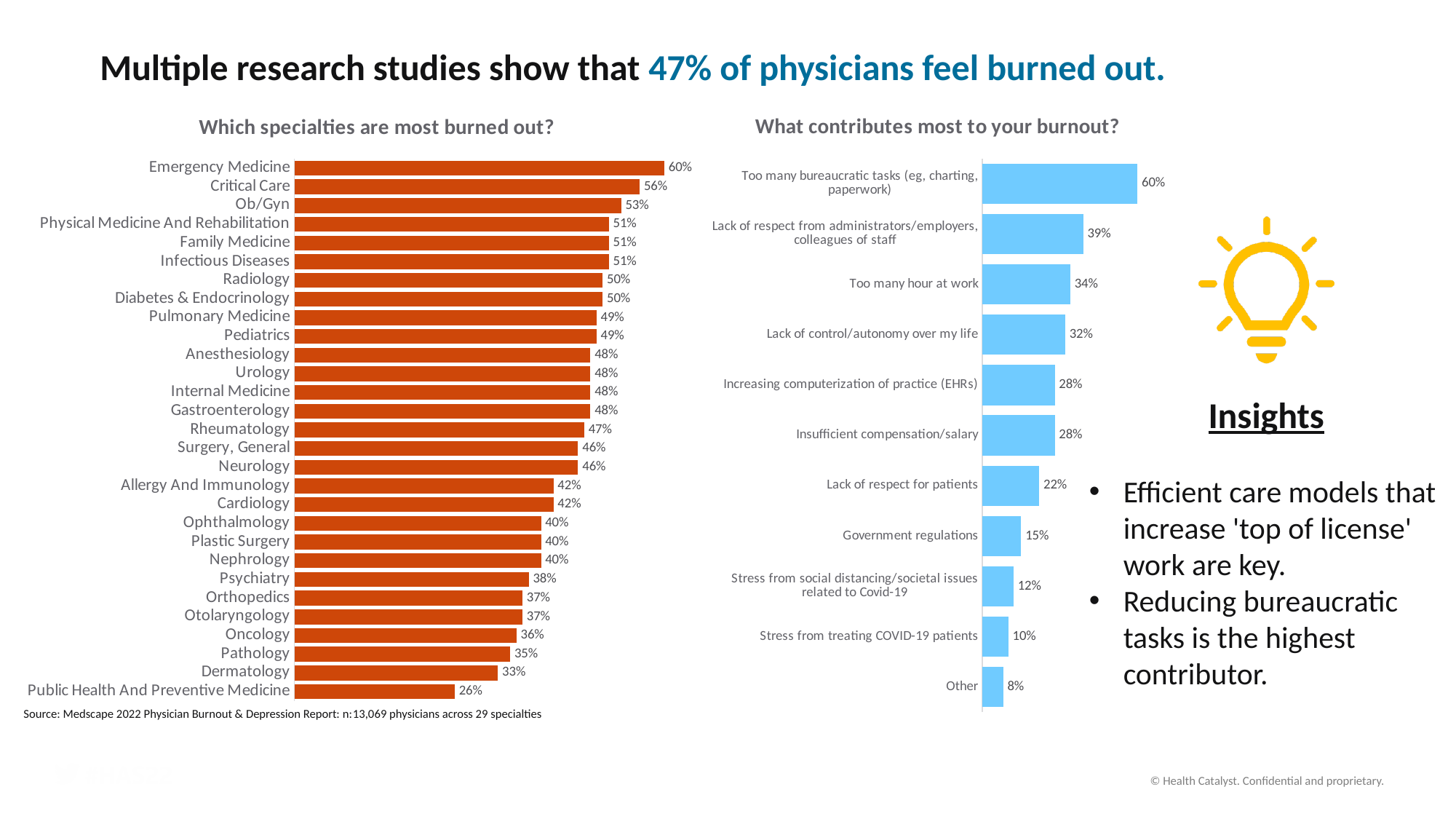
What type of chart is 'What contributes most to your burnout?' Bar chart In the chart 'Which specialties are most burned out?', what is the value for Psychiatry? 38% How many specialties are shown in the chart 'Which specialties are most burned out?' 29 In the chart 'What contributes most to your burnout?', what is the difference between Lack of respect from administrators/employers, colleagues of staff and Government regulations? 24% How many categories are shown in the chart 'What contributes most to your burnout?' 11 In the chart 'What contributes most to your burnout?', which category has the highest value? Too many bureaucratic tasks (eg, charting, paperwork) In the chart 'Which specialties are most burned out?', what is the difference between Critical Care and Dermatology? 23% In the chart 'Which specialties are most burned out?', which is larger, Cardiology or Oncology? Cardiology In the chart 'What contributes most to your burnout?', what is the value for Too many hour at work? 34% In the chart 'Which specialties are most burned out?', what is the value for Emergency Medicine? 60% In the chart 'Which specialties are most burned out?', which specialty has the lowest value? Public Health And Preventive Medicine What colour are the bars in the chart 'Which specialties are most burned out?' Orange